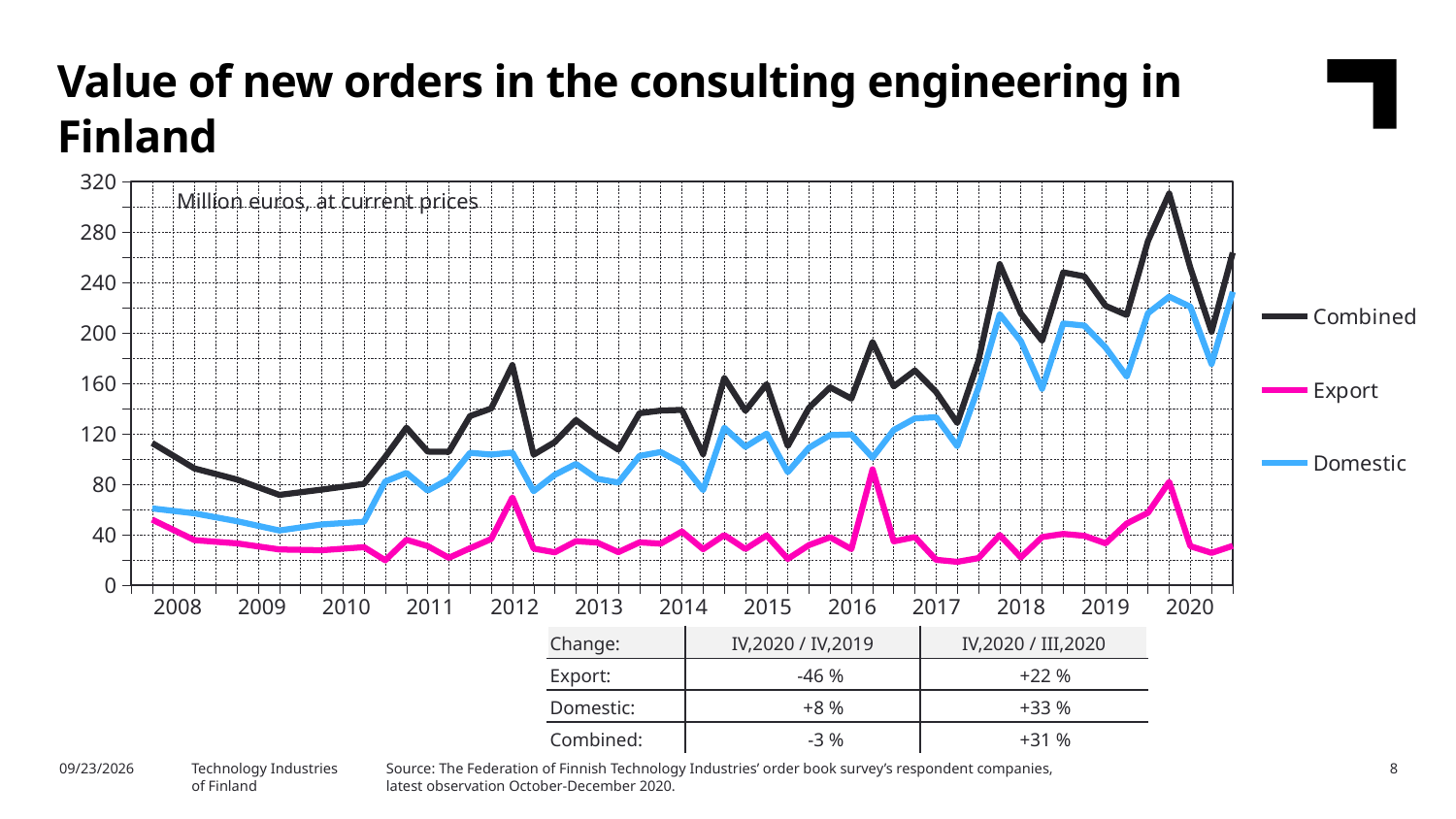
How many years are labelled on the x axis of the chart? 13 What unit is stated on the chart for the plotted values? Million euros, at current prices How many series does the chart legend list? 3 Does the Domestic series generally rise or fall from 2008 to 2020? Rise Which series has the lowest values throughout the chart? Export According to the change table, what is the Export change for IV,2020 / IV,2019? -46 % Which series reaches the highest value on the chart? Combined What are the three series named in the chart legend? Combined, Export, Domestic Is the value of the Domestic series at the start of 2008 greater or less than 80? less In 2020, which series is larger, Domestic or Export? Domestic What kind of chart is shown on the slide? Line chart